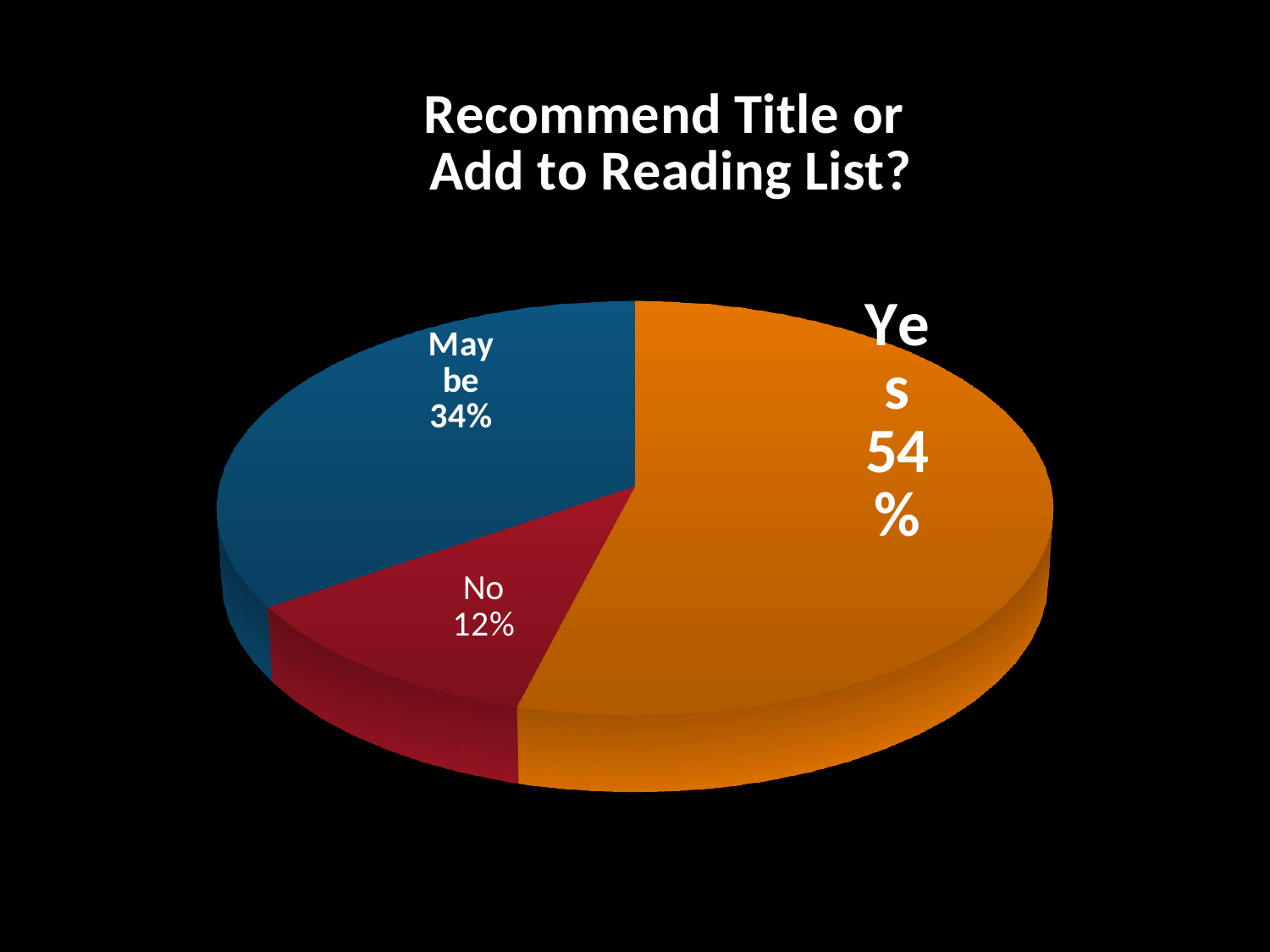
What percentage of responses are "No"? 12% What is the difference in percentage points between "Yes" and "Maybe"? 20 What kind of chart is shown on the slide? Pie chart What percentage of responses are "Maybe"? 34% What percentage of responses are "Yes"? 54% What colour is the "No" slice? Red Which is larger, the share for "Maybe" or the share for "No"? Maybe What is the title of the chart? Recommend Title or Add to Reading List? Which response has the largest share of the pie? Yes Which response has the smallest share of the pie? No How many slices does the pie chart have? 3 What is the difference in percentage points between "Maybe" and "No"? 22